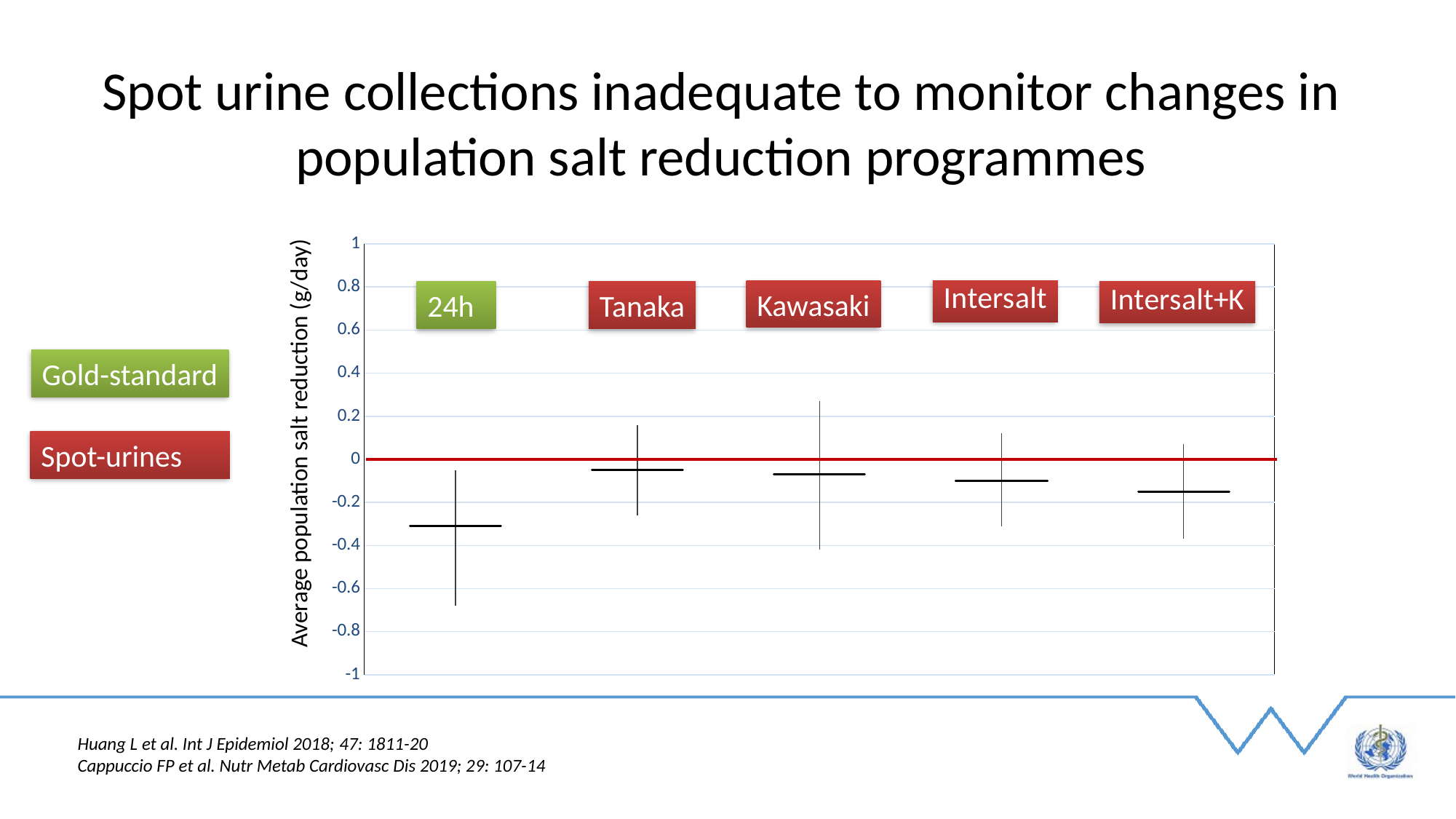
Is the value for Intersalt+K greater or less than -0.4? greater How many estimation methods are plotted on the chart? 5 Which has the larger value, Tanaka or Intersalt? Tanaka Is the value for Tanaka greater or less than -0.2? greater What is the label of the y axis? Average population salt reduction (g/day) Which method shows the lowest (most negative) average population salt reduction? 24h What is the maximum value shown on the y axis? 1 Which has the larger value, 24h or Intersalt+K? Intersalt+K Is the value for Kawasaki greater or less than 0? less Which method is labelled in green as the gold standard? 24h What kind of chart is shown? An error bar chart (point estimates with confidence intervals)